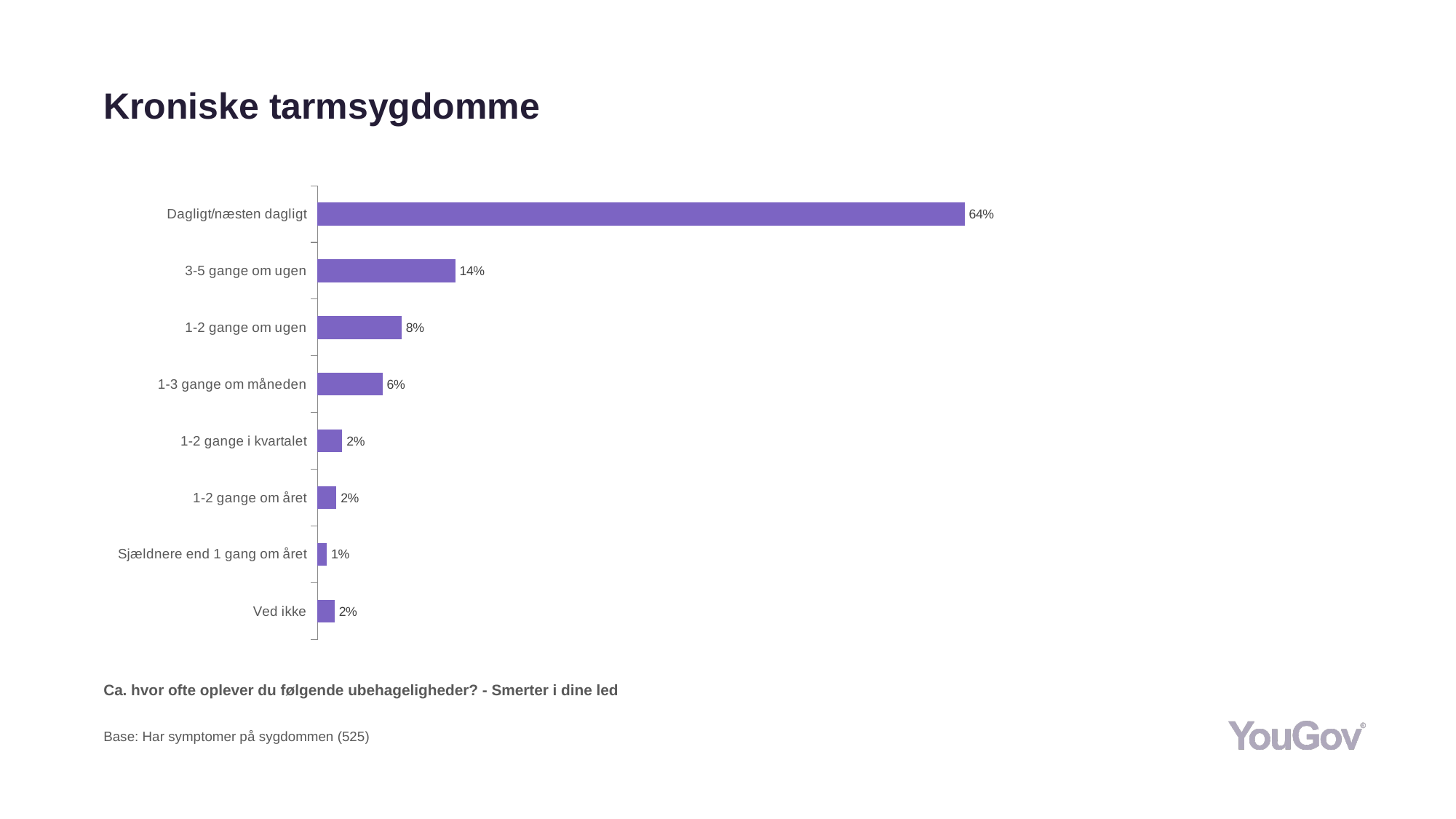
What is the difference between '1-2 gange om ugen' and '1-3 gange om måneden'? 2 percentage points Which is larger, '1-2 gange om ugen' or '1-3 gange om måneden'? 1-2 gange om ugen What is the value for '1-3 gange om måneden'? 6% How many categories are shown in the chart? 8 What is the title of the slide? Kroniske tarmsygdomme What is the value for '3-5 gange om ugen'? 14% Which category has the highest value? Dagligt/næsten dagligt What is the difference between 'Dagligt/næsten dagligt' and '3-5 gange om ugen'? 50 percentage points What type of chart is shown on the slide? Bar chart What is the value for 'Sjældnere end 1 gang om året'? 1% Which category has the lowest value? Sjældnere end 1 gang om året What percentage is shown for 'Dagligt/næsten dagligt'? 64%